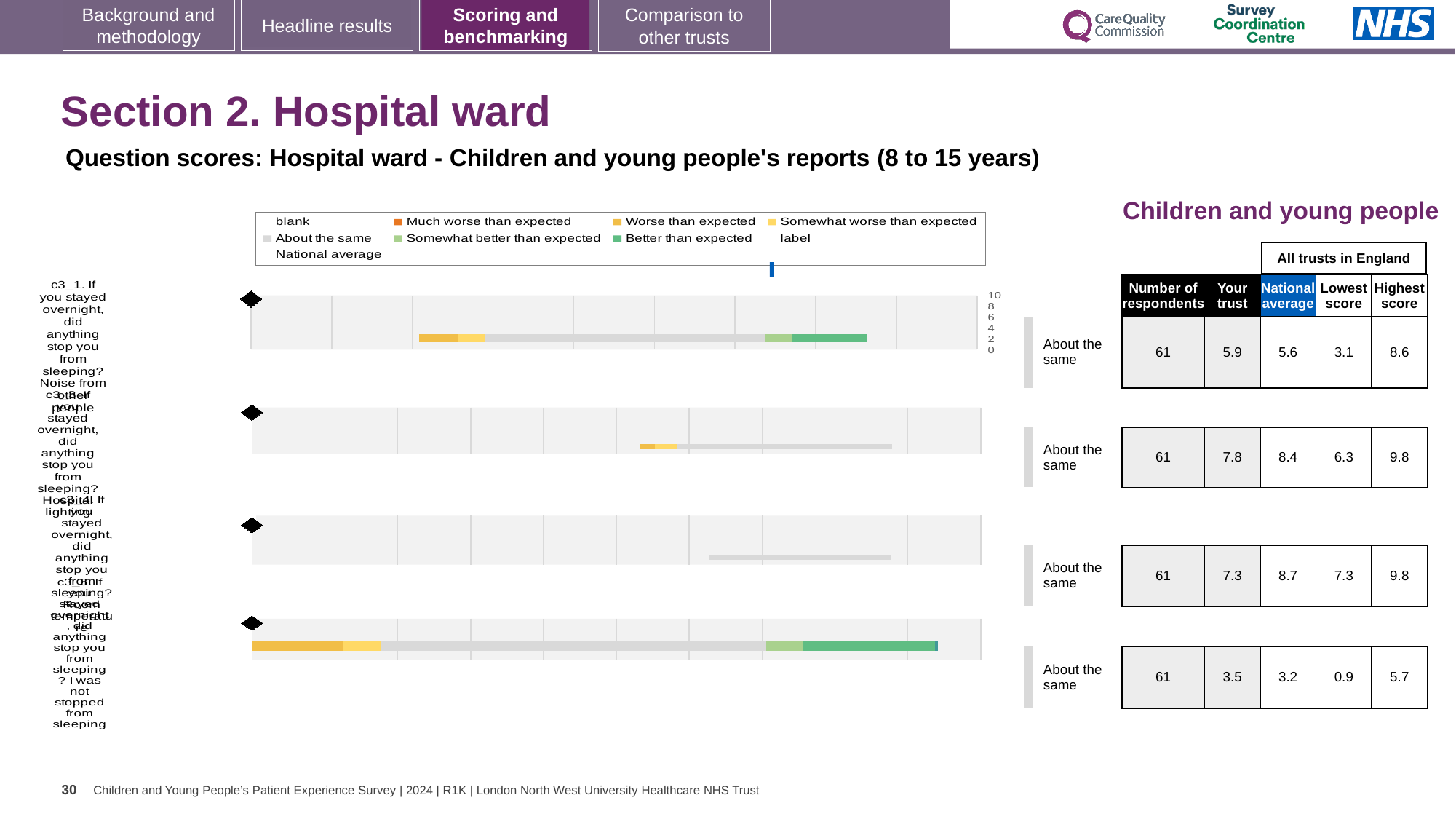
How many question rows (bars) are plotted in the chart? 4 What benchmark label is shown next to each of the four question rows? About the same In the table beside the chart, what is the national average for the fourth question row (c3_6, I was not stopped from sleeping)? 3.2 How many entries does the chart legend list? 9 How many respondents are listed for each question row in the table? 61 Which question row has the highest 'Your trust' score in the table? the second row (c3_3), 7.8 For the second question row (c3_3), what is the difference between the national average (8.4) and the 'Your trust' score (7.8)? 0.6 What is the subtitle above the chart? Question scores: Hospital ward - Children and young people's reports (8 to 15 years) Which question row has the lowest 'Your trust' score in the table? the fourth row (c3_6), 3.5 For the first question row (c3_1), which is larger: the 'Your trust' score or the national average? Your trust In the table beside the chart, what is the 'Your trust' score for the first question row (c3_1, noise from other people)? 5.9 What kind of chart is used to show the question scores on this slide? bar chart